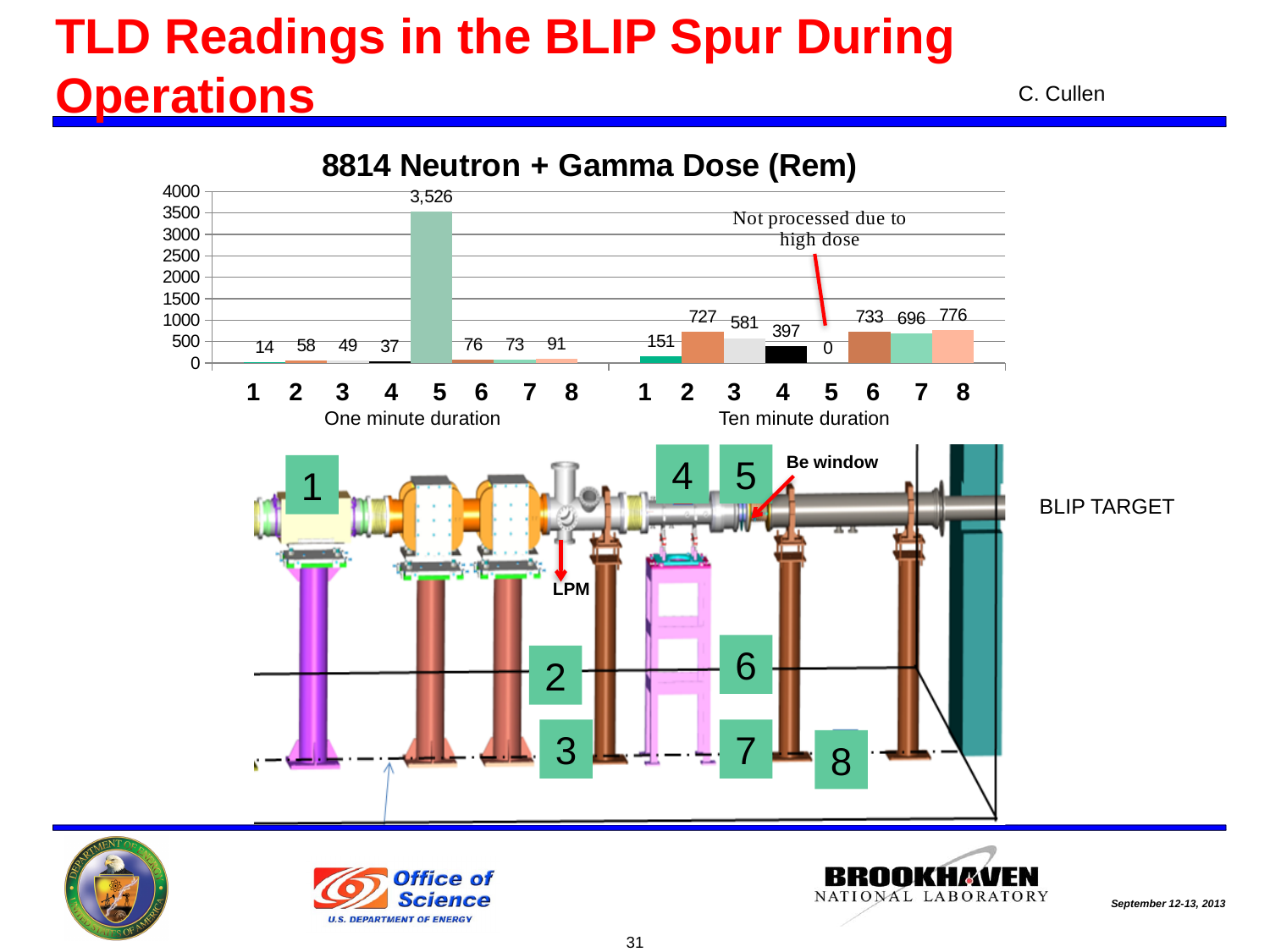
What is the dose value for position 5 in the one minute duration group? 3,526 Why is the value for position 5 in the ten minute duration group shown as 0? Not processed due to high dose What is the title of the chart? 8814 Neutron + Gamma Dose (Rem) Which is larger, the dose at position 6 or position 7 in the ten minute duration group? position 6 What is the dose value for position 1 in the ten minute duration group? 151 Which position has the lowest dose in the one minute duration group? 1 How many positions are plotted in each duration group? 8 Which position has the highest dose in the one minute duration group? 5 What is the difference between the dose at position 2 and position 3 in the ten minute duration group? 146 What is the dose value for position 8 in the ten minute duration group? 776 What is the difference between the dose at position 8 and position 1 in the one minute duration group? 77 What kind of chart is shown on the slide? bar chart